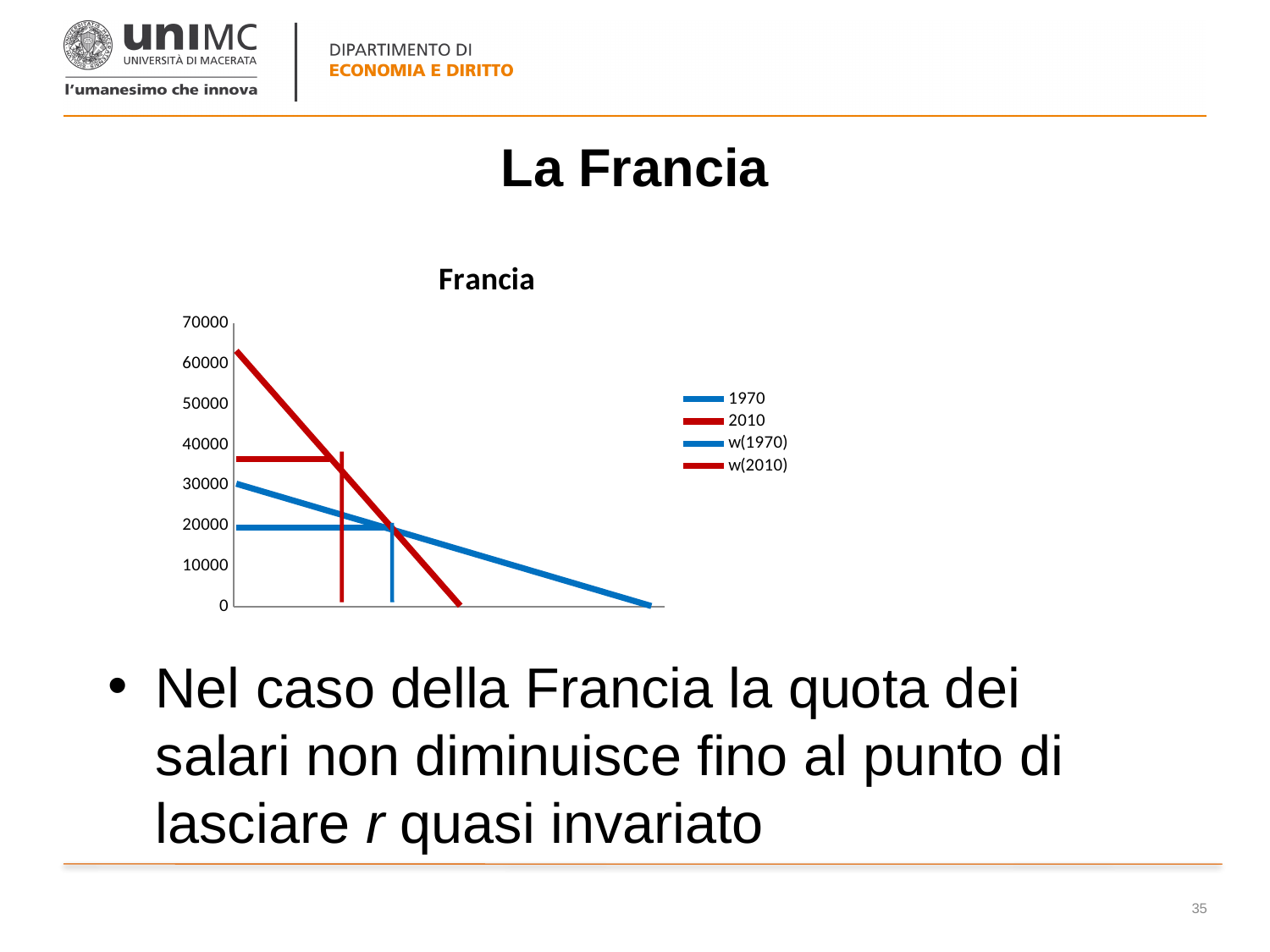
Is the level of the horizontal w(1970) line greater or less than 10000? greater Which horizontal line is at a higher level, w(1970) or w(2010)? w(2010) Is the level of the horizontal w(2010) line greater or less than 30000? greater What kind of chart is shown on the slide? line chart Does the 1970 line rise or fall as it moves along the x axis? fall Which line starts higher on the y axis, 1970 or 2010? 2010 Is the level of the horizontal w(2010) line greater or less than 40000? less What is the title of the chart? Francia How many series does the legend of the chart list? 4 Which series are listed in the legend of the chart? 1970, 2010, w(1970), w(2010) Does the 2010 line rise or fall as it moves along the x axis? fall